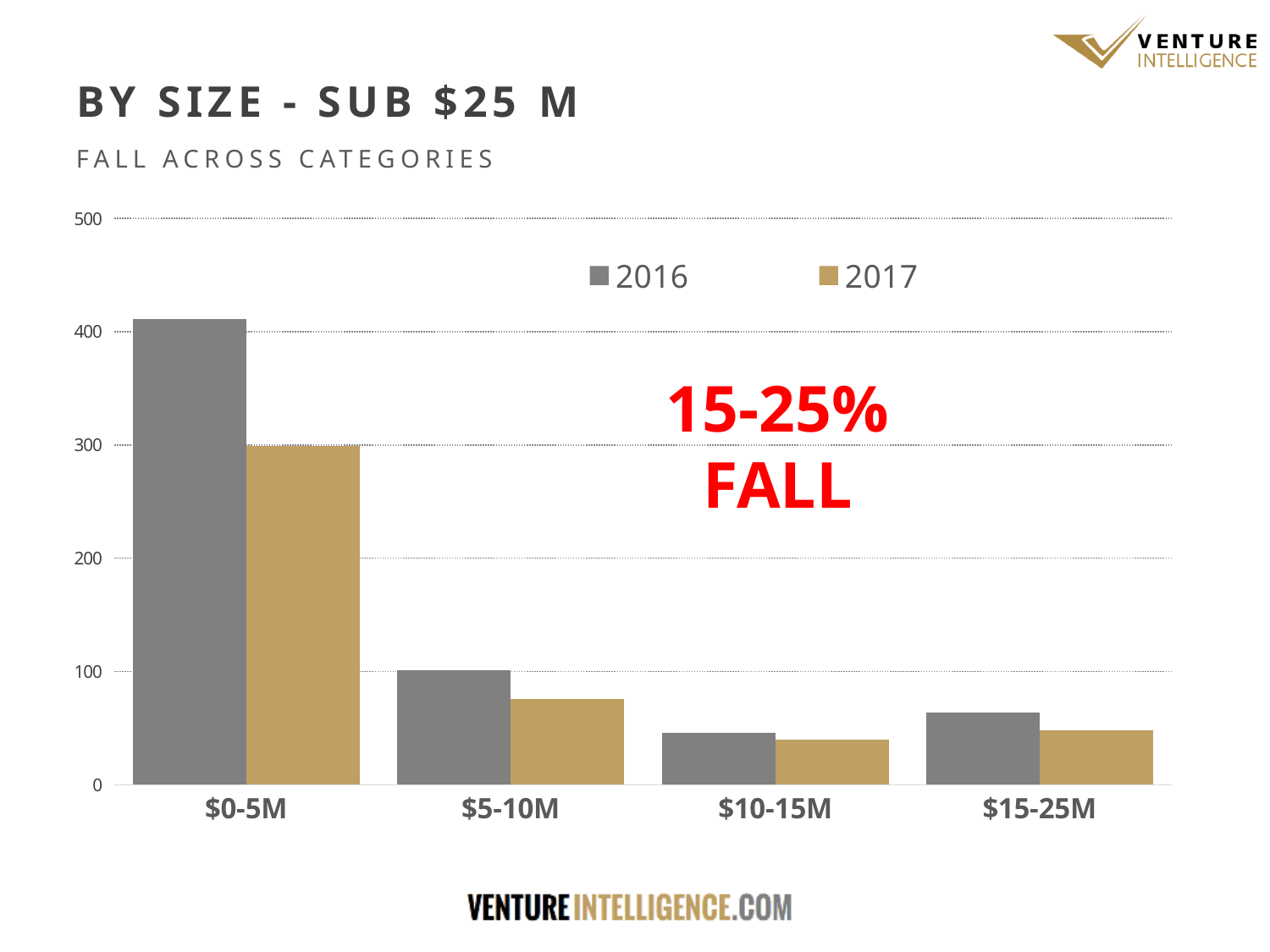
Is the 2016 value for $15-25M greater or less than 100? less For the $0-5M category, which year has the larger value, 2016 or 2017? 2016 How many series does the legend list? 2 Do the 2016 values generally rise or fall from $0-5M to $10-15M? fall Which size category has the highest 2016 value? $0-5M What kind of chart is shown on the slide? bar chart How many size categories are shown on the x axis? 4 Which size category has the lowest 2017 value? $10-15M Is the 2017 value for $5-10M greater or less than 100? less What is the title of the slide containing the chart? BY SIZE - SUB $25 M Which is larger: the 2016 value for $5-10M or the 2016 value for $15-25M? $5-10M Is the 2016 value for $0-5M greater or less than 400? greater